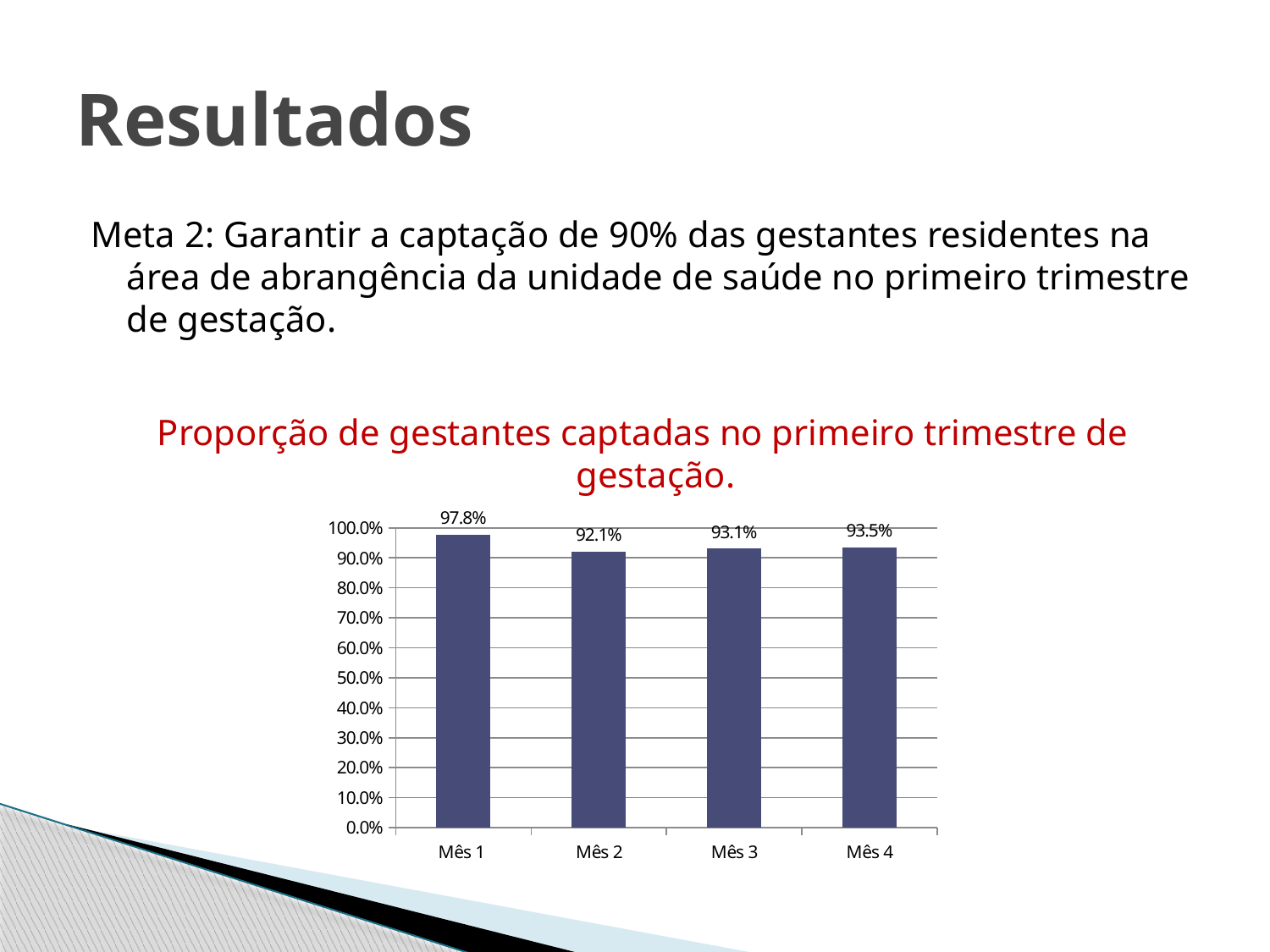
Which is larger, the value for Mês 3 or the value for Mês 4? Mês 4 What is the title of the chart? Proporção de gestantes captadas no primeiro trimestre de gestação. What is the value for Mês 3? 93.1% What is the value for Mês 1? 97.8% How many months are shown on the x axis? 4 Is the value for Mês 2 greater or less than 90.0%? greater What is the difference between the values for Mês 1 and Mês 2? 5.7% Which month has the lowest value? Mês 2 What is the value for Mês 4? 93.5% What is the value for Mês 2? 92.1% What kind of chart is shown on the slide? bar chart Which month has the highest value? Mês 1